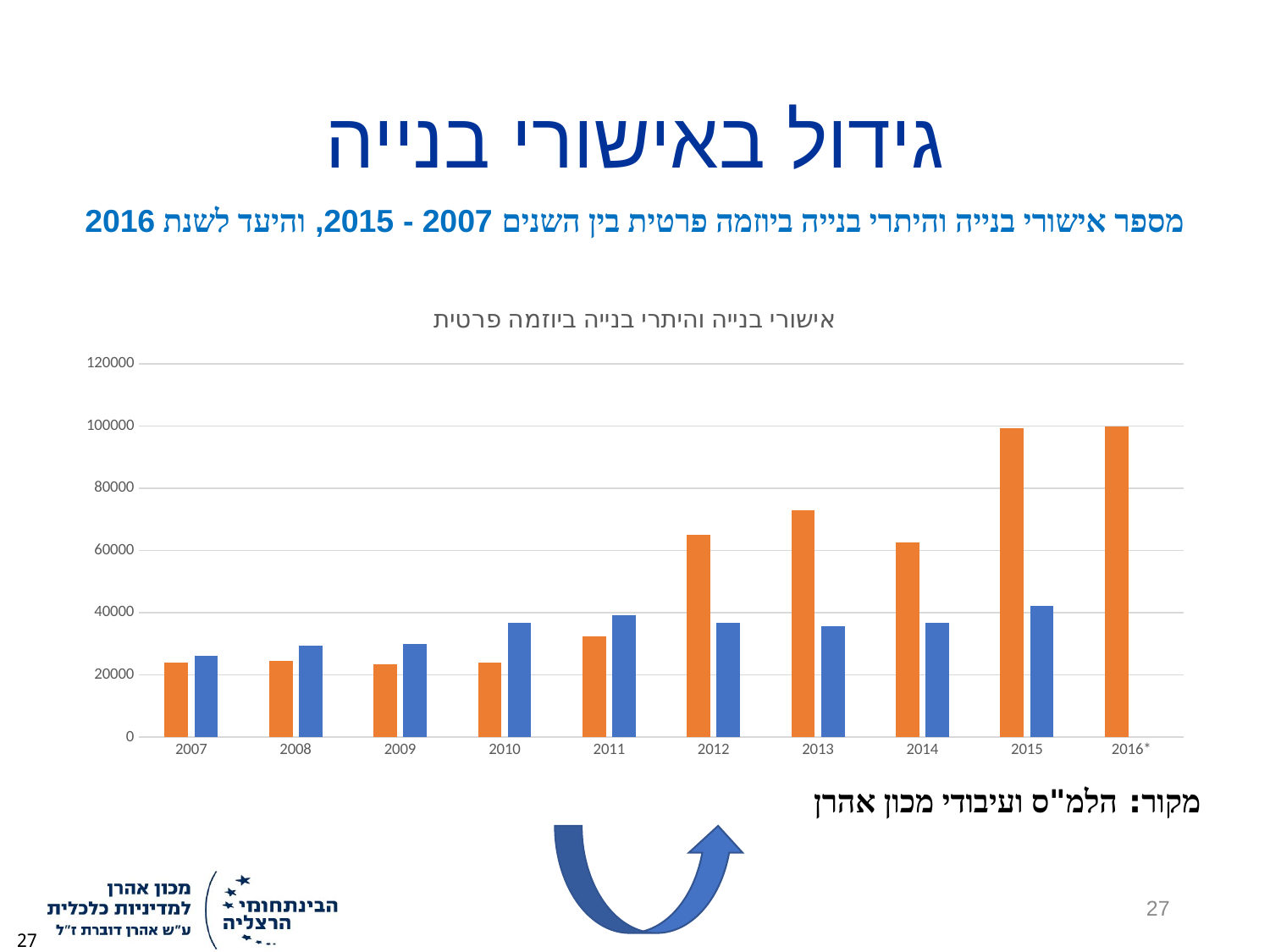
Which year on the x axis is marked with an asterisk? 2016* Is the value of the orange bar for 2007 greater or less than 20000? greater Is the value of the orange bar for 2015 greater or less than 80000? greater What is the title of the chart? אישורי בנייה והיתרי בנייה ביוזמה פרטית How many years are shown on the x axis of the chart? 10 For 2012, which bar is larger, the orange one or the blue one? orange In which year is the blue bar the highest? 2015 For 2007, which bar is larger, the orange one or the blue one? blue In which year is the blue bar the lowest? 2007 Is the value of the orange bar for 2013 greater or less than 80000? less What kind of chart is shown on the slide? bar chart